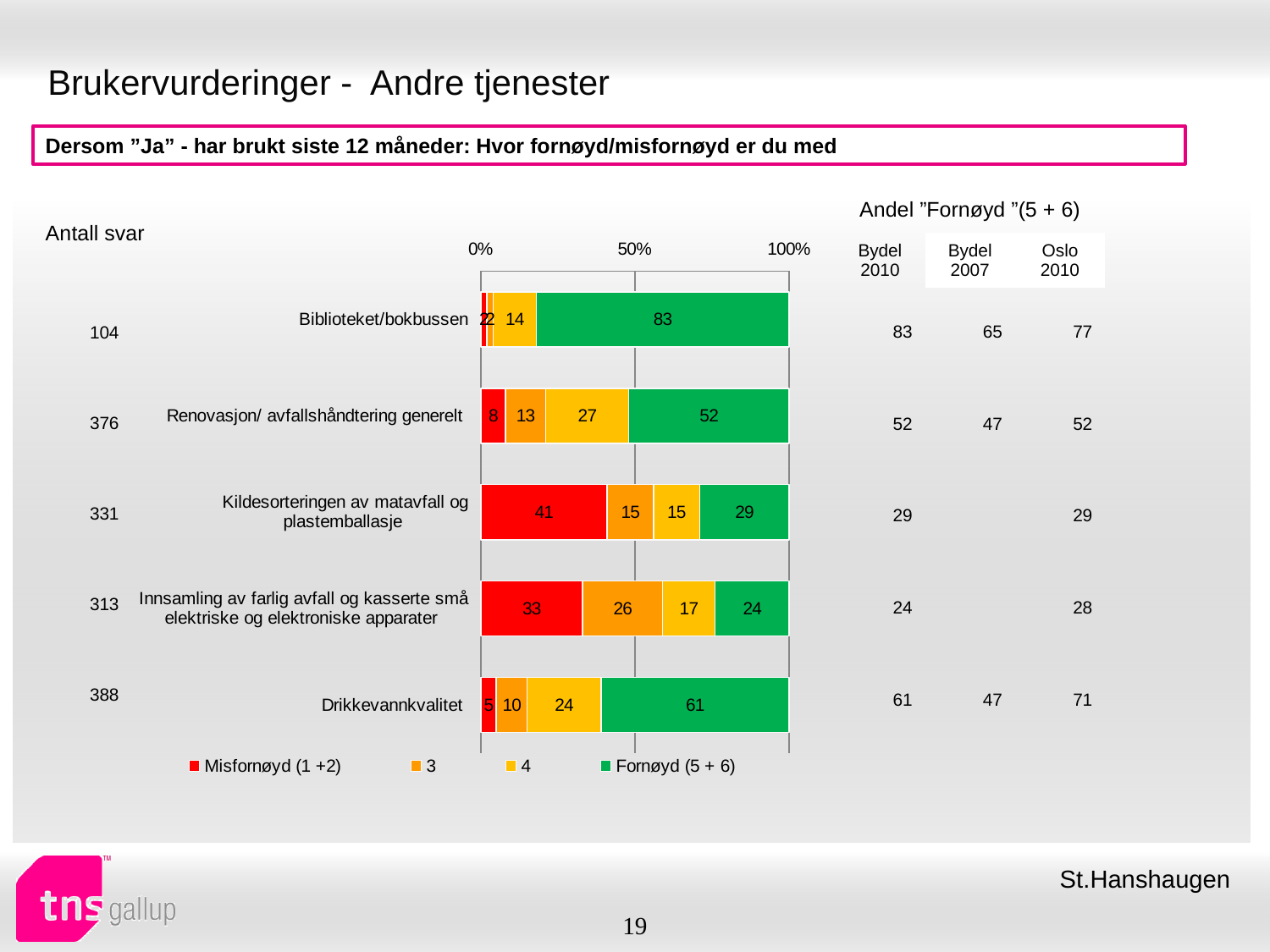
How many service categories are plotted in the chart? 5 Which category has the lowest Fornøyd (5 + 6) value? Innsamling av farlig avfall og kasserte små elektriske og elektroniske apparater What is the value of the '4' segment for Drikkevannkvalitet? 24 Which category has the highest Fornøyd (5 + 6) value? Biblioteket/bokbussen What is the Misfornøyd (1 +2) value for Kildesorteringen av matavfall og plastemballasje? 41 What colour represents the Fornøyd (5 + 6) series in the chart? Green What is the value of the '3' segment for Innsamling av farlig avfall og kasserte små elektriske og elektroniske apparater? 26 What is the Fornøyd (5 + 6) value for Renovasjon/ avfallshåndtering generelt? 52 What kind of chart is shown on the slide? Stacked bar chart What is the difference between the Fornøyd (5 + 6) values for Drikkevannkvalitet and Renovasjon/ avfallshåndtering generelt? 9 How many series does the chart legend list? 4 Which has the larger Misfornøyd (1 +2) value: Kildesorteringen av matavfall og plastemballasje or Innsamling av farlig avfall og kasserte små elektriske og elektroniske apparater? Kildesorteringen av matavfall og plastemballasje